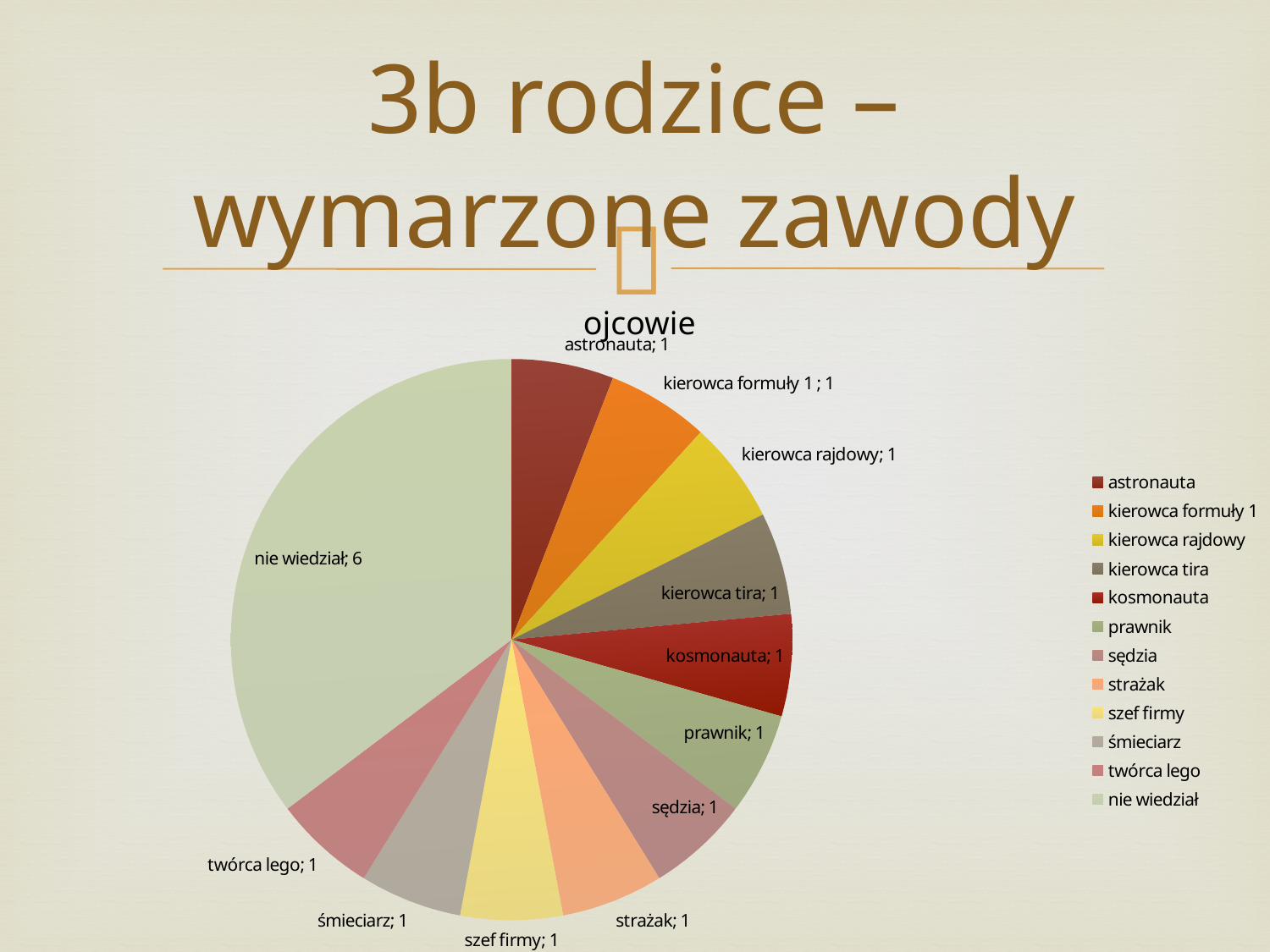
What is the total of all the values in the pie chart? 17 What share of the total does 'nie wiedział' represent? 6 out of 17 What is the value for 'nie wiedział'? 6 Which category has the largest slice? nie wiedział What is the difference between the value for 'nie wiedział' and the value for 'strażak'? 5 What is the value for 'kierowca tira'? 1 What is the value for 'twórca lego'? 1 How many entries does the legend list? 12 What kind of chart is shown on the slide? pie chart Which is larger, the value for 'nie wiedział' or the value for 'prawnik'? nie wiedział How many categories does the pie chart have? 12 What is the title of the chart? ojcowie